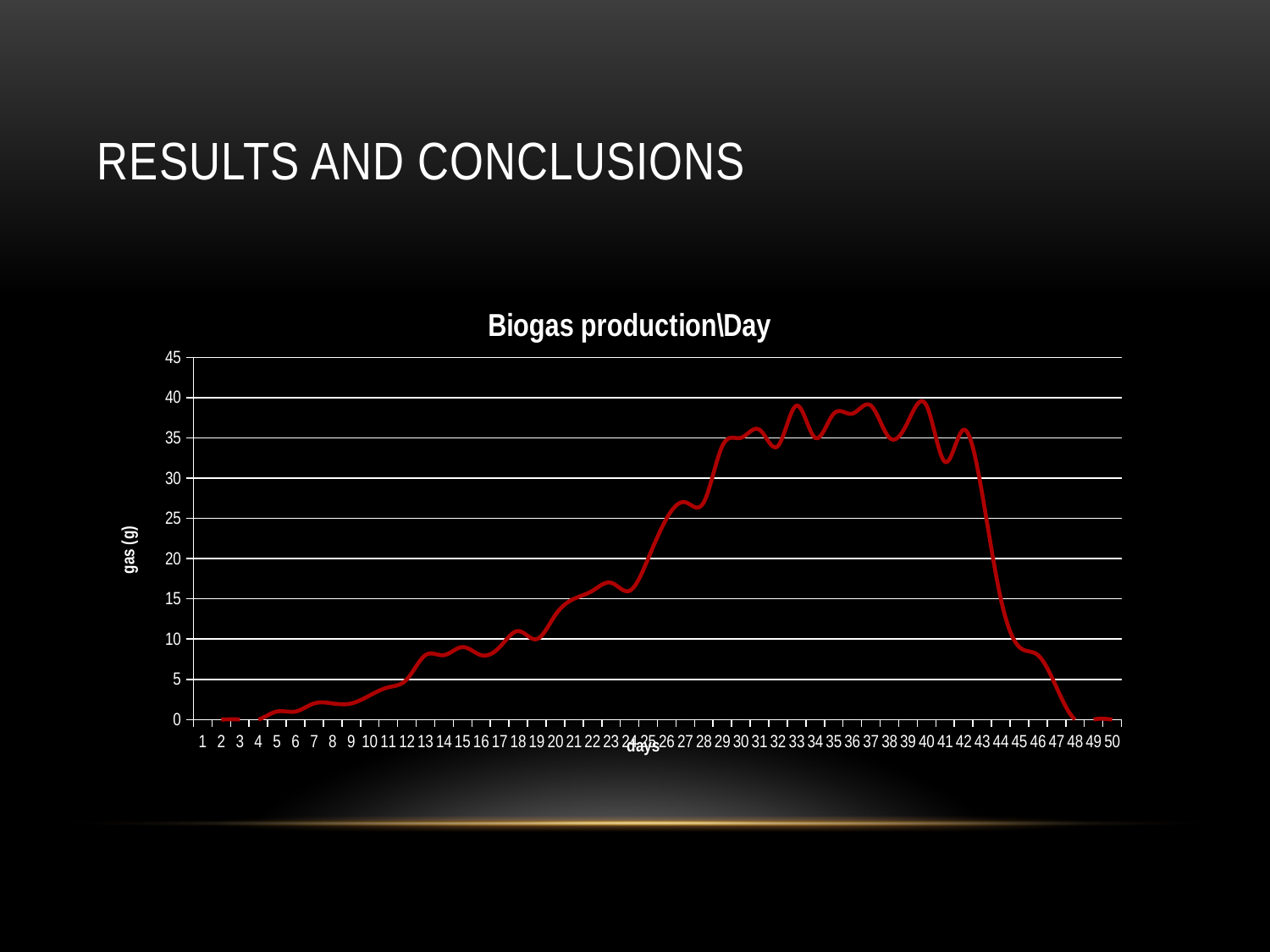
How many days are plotted along the x axis of the chart? 50 Which has the larger value, day 40 or day 47? day 40 Is the value for day 20 greater or less than 10? greater Which has the larger value, day 10 or day 30? day 30 Is the value for day 47 greater or less than 10? less What kind of chart is shown on the slide? line chart Is the value for day 10 greater or less than 5? less Do the values generally rise or fall from day 1 to day 40? rise What is the title of the chart? Biogas production\Day What is the label of the vertical axis of the chart? gas (g)